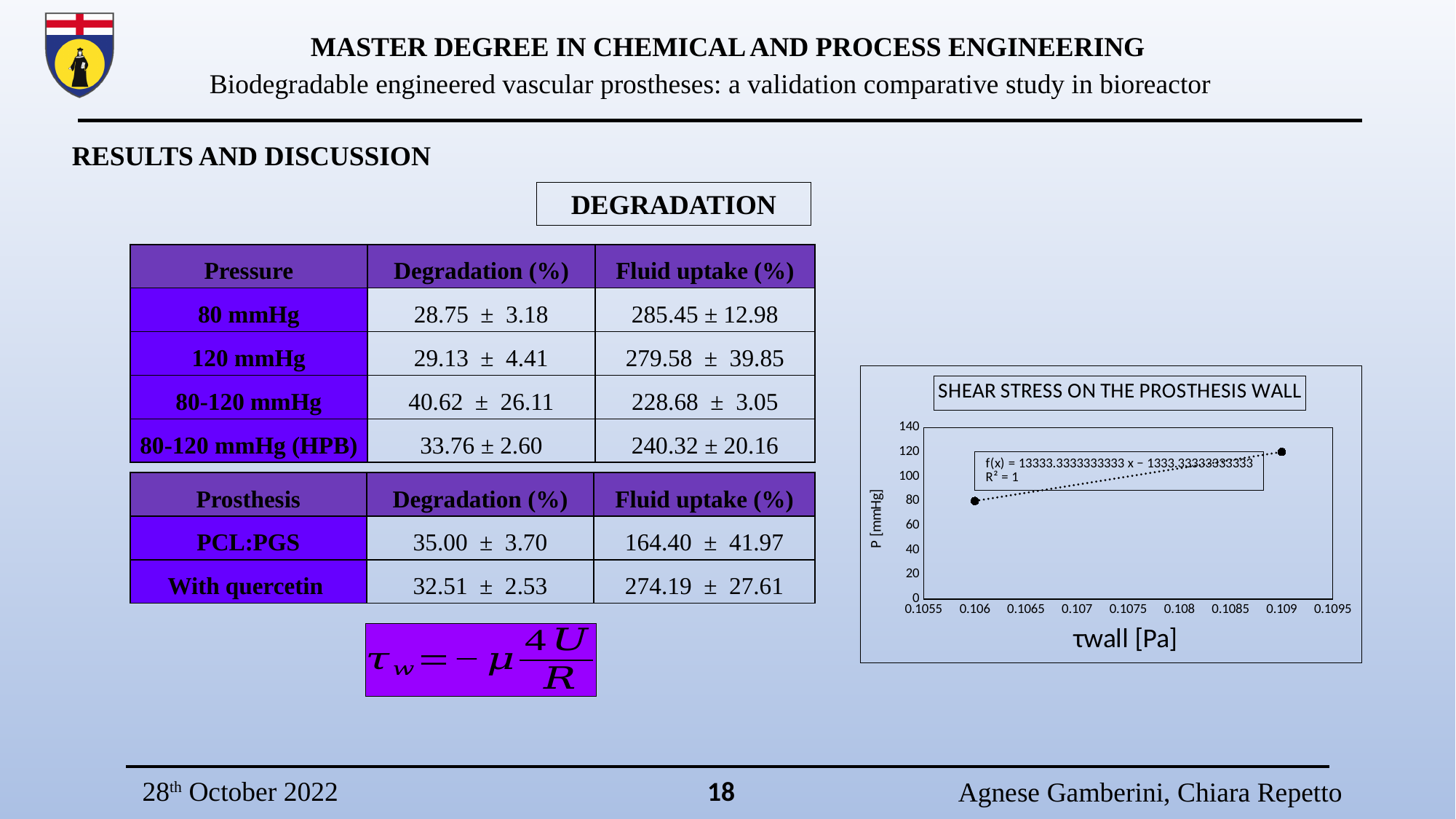
What R² value is shown for the trendline in the chart? R² = 1 Do the plotted values rise or fall as τwall increases along the x axis? rise What kind of chart is shown on the slide? scatter chart What is the highest value shown on the y axis of the chart? 140 Which of the two plotted points has the higher P value: the one at τwall = 0.106 Pa or the one at τwall = 0.109 Pa? the one at 0.109 Pa How many data points are plotted in the chart? 2 What is the lowest value shown on the x axis of the chart? 0.1055 Is the P value of the point at τwall = 0.106 Pa greater or less than 100? less What is the label of the y axis of the chart? P [mmHg] What is the title of the chart on the slide? SHEAR STRESS ON THE PROSTHESIS WALL Is the P value of the point at τwall = 0.109 Pa greater or less than 100? greater